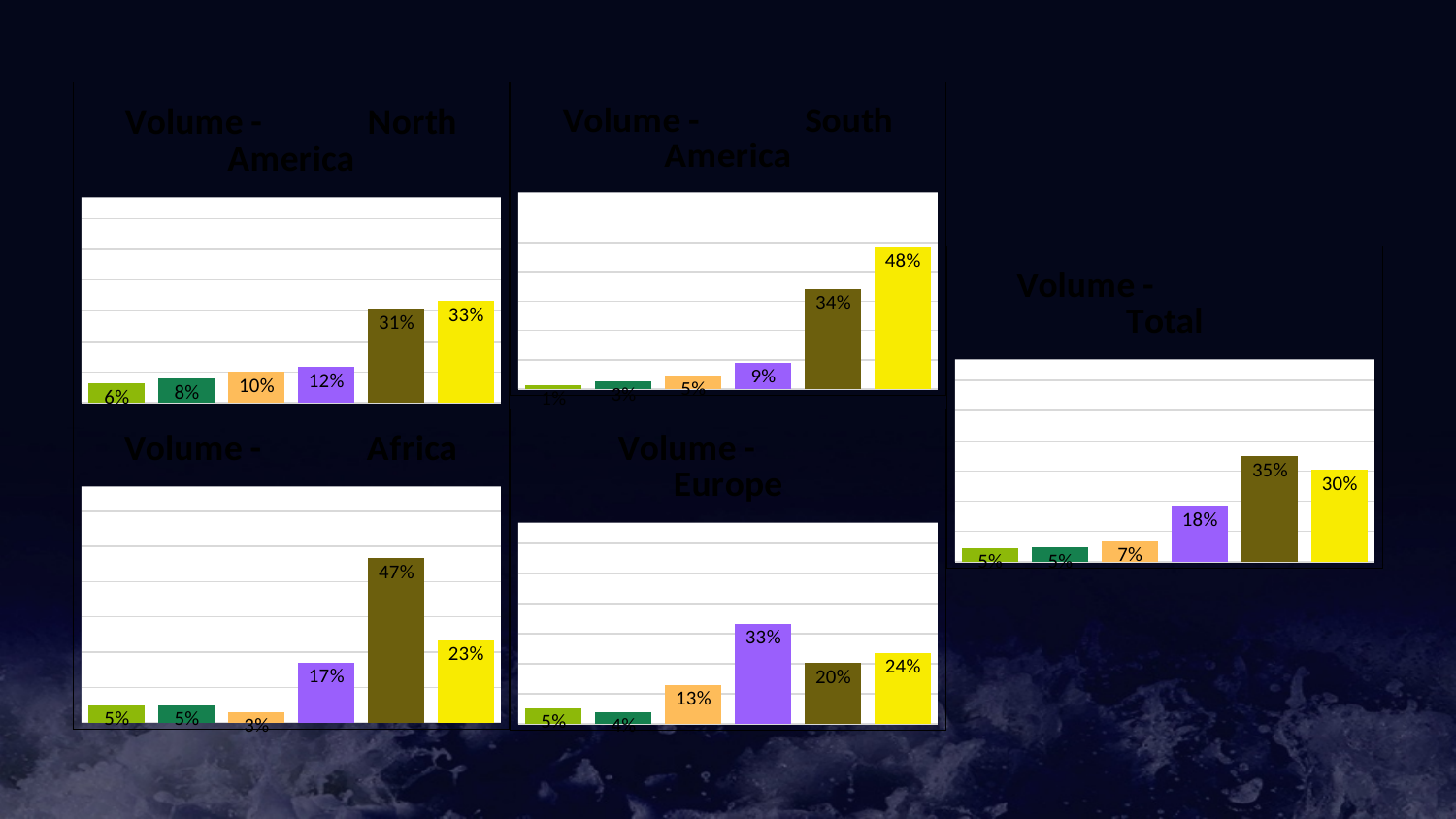
In the Volume - Total chart, what is the value of the purple bar? 18% In the Volume - Europe chart, what is the value of the purple bar? 33% How many charts are shown on the slide? 5 What type of chart is the Volume - Europe chart? bar chart In the Volume - Africa chart, what is the difference between the olive (dark yellow) bar and the yellow bar? 24% In the Volume - North America chart, what is the value of the orange bar? 10% In the Volume - Africa chart, what is the value of the olive (dark yellow) bar? 47% In the Volume - North America chart, what is the value of the yellow bar? 33% In the Volume - South America chart, what is the value of the tallest bar? 48% How many bars are plotted in the Volume - North America chart? 6 In the Volume - Total chart, which bar is taller: the olive (dark yellow) bar or the yellow bar? the olive (dark yellow) bar In the Volume - Europe chart, what is the difference between the yellow bar and the olive (dark yellow) bar? 4%